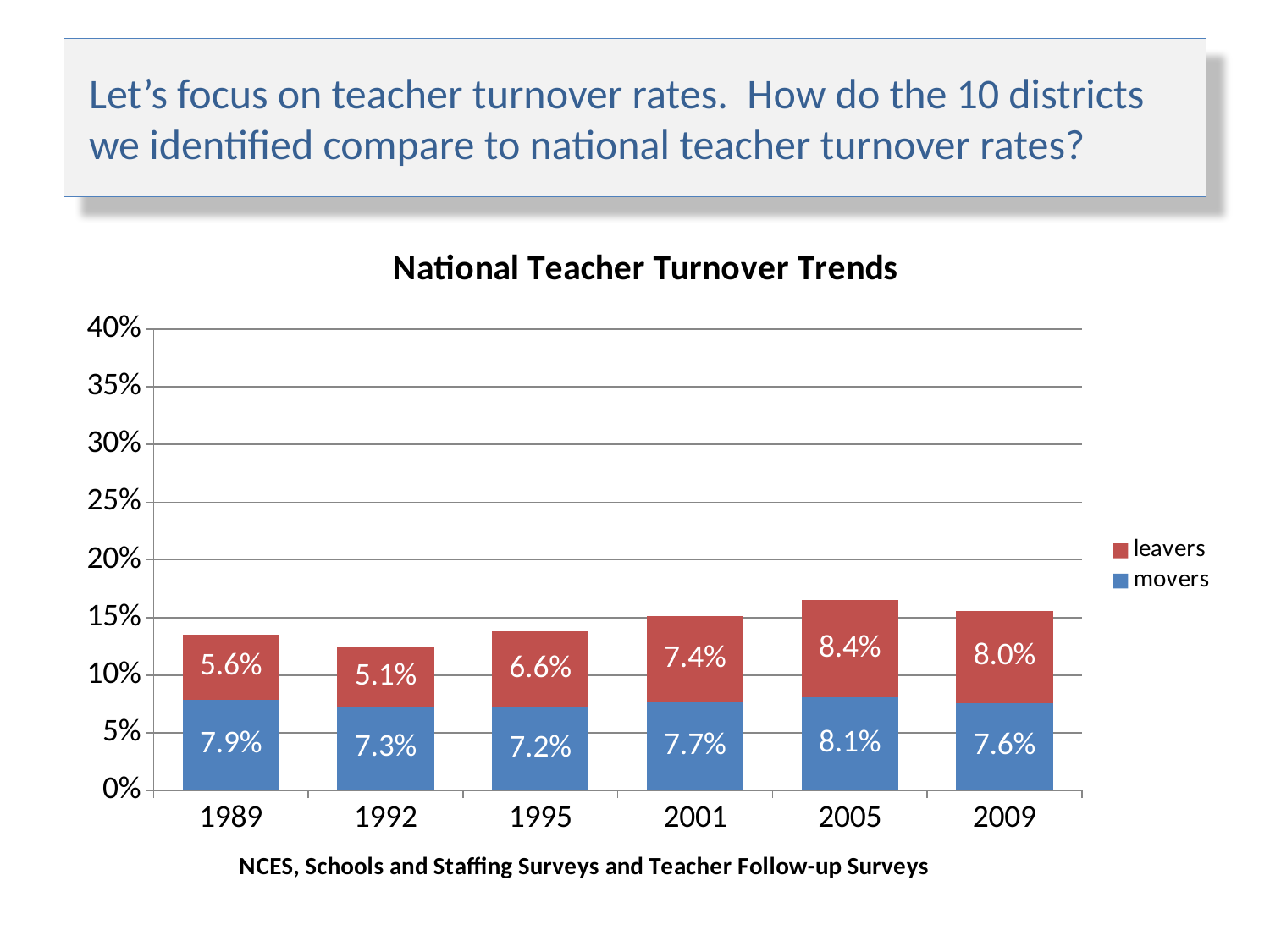
What is the total of the stacked bar for 1992? 12.4% What is the value for leavers in 2009? 8.0% What is the total of the stacked bar for 2005? 16.5% What kind of chart is shown on the slide? Stacked bar chart How many series does the legend list? 2 What is the value for leavers in 1992? 5.1% Which year has the highest value for leavers? 2005 What is the difference between the leavers values for 2005 and 1989? 2.8% How many years are shown on the x axis? 6 Which is larger, the movers value in 1989 or the movers value in 1992? 1989 What is the value for movers in 2005? 8.1% Which year has the lowest value for movers? 1995